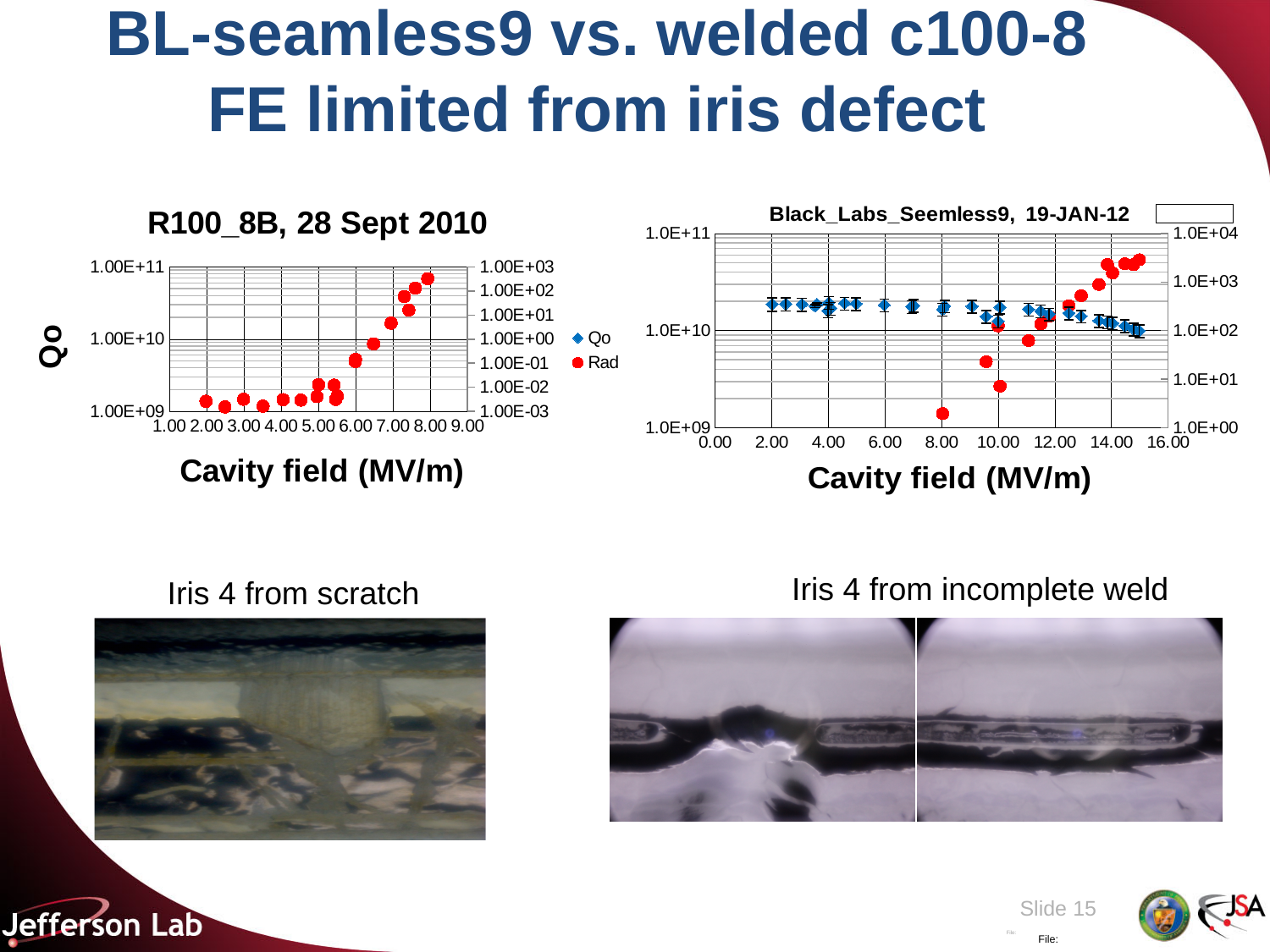
In the right chart "Black_Labs_Seemless9, 19-JAN-12", do the Rad values rise or fall as the cavity field increases from 8.00 to 15.00 MV/m? rise In the left chart "R100_8B, 28 Sept 2010", is the Rad value at a cavity field of 2.00 MV/m greater or less than 1.00E-01? less What kind of chart is the left chart titled "R100_8B, 28 Sept 2010"? scatter chart In the right chart "Black_Labs_Seemless9, 19-JAN-12", is the Rad value at a cavity field of 8.00 MV/m greater or less than 1.0E+01? less In the left chart "R100_8B, 28 Sept 2010", is the Rad value at a cavity field of 8.00 MV/m greater or less than 1.00E+02? greater What are the two series named in the legend of the left chart "R100_8B, 28 Sept 2010"? Qo and Rad In the left chart "R100_8B, 28 Sept 2010", do the Rad values rise or fall as the cavity field increases? rise In the right chart "Black_Labs_Seemless9, 19-JAN-12", do the Qo values rise or fall as the cavity field increases? fall What is the x-axis label of the right chart "Black_Labs_Seemless9, 19-JAN-12"? Cavity field (MV/m) What is the title of the right chart? Black_Labs_Seemless9, 19-JAN-12 How many series does the legend of the left chart "R100_8B, 28 Sept 2010" list? 2